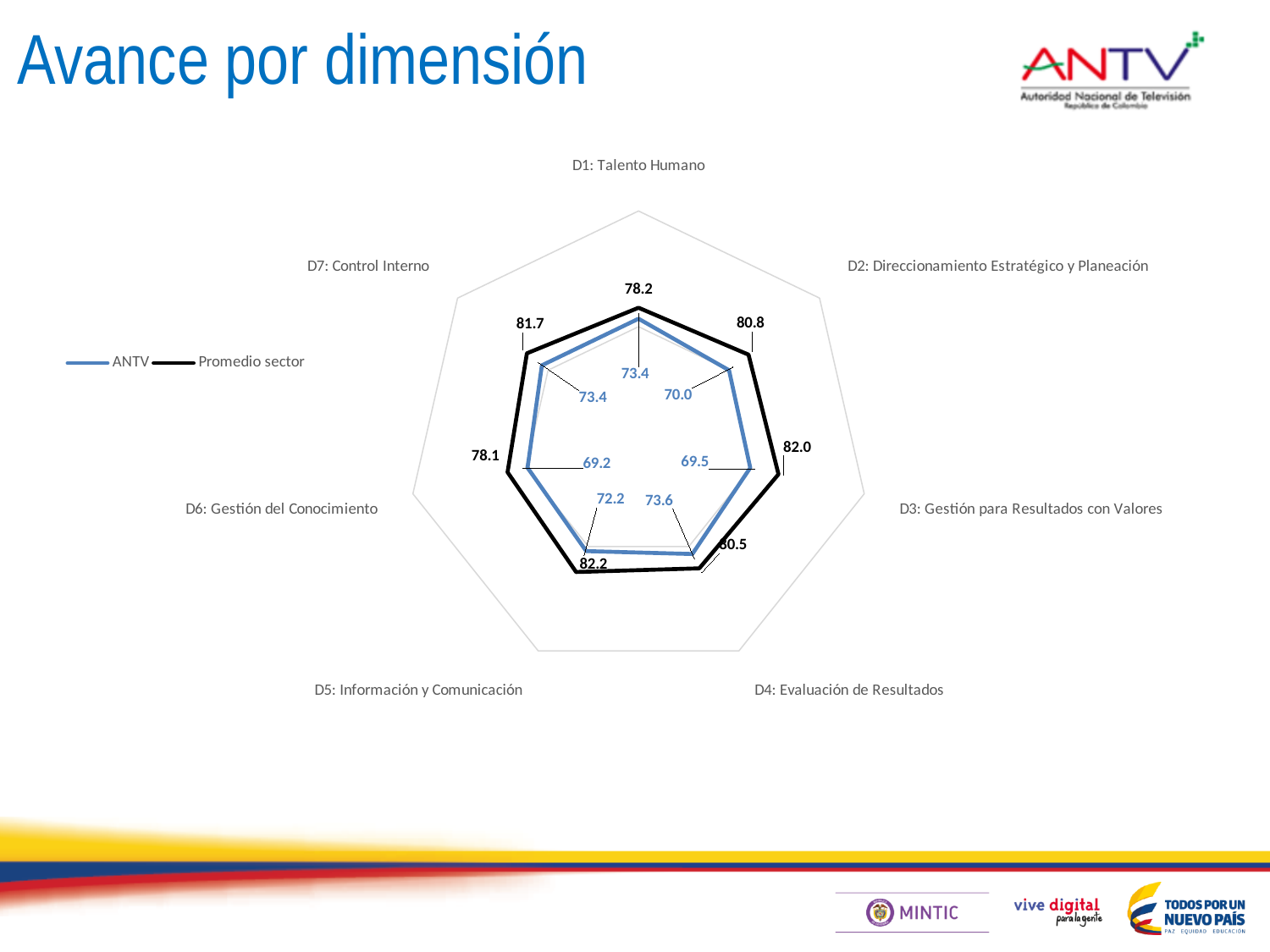
For D7: Control Interno, which series has the larger value, ANTV or Promedio sector? Promedio sector What is the Promedio sector value for D5: Información y Comunicación? 82.2 Which dimension has the highest Promedio sector value? D5: Información y Comunicación How many series does the legend list? 2 Which series is drawn with the blue line? ANTV What is the Promedio sector value for D3: Gestión para Resultados con Valores? 82.0 What is the ANTV value for D2: Direccionamiento Estratégico y Planeación? 70.0 What type of chart is shown on the slide? Radar chart How many dimensions (categories) are plotted on the radar chart? 7 What is the ANTV value for D1: Talento Humano? 73.4 Which dimension has the lowest ANTV value? D6: Gestión del Conocimiento What is the difference between the Promedio sector and ANTV values for D3: Gestión para Resultados con Valores? 12.5